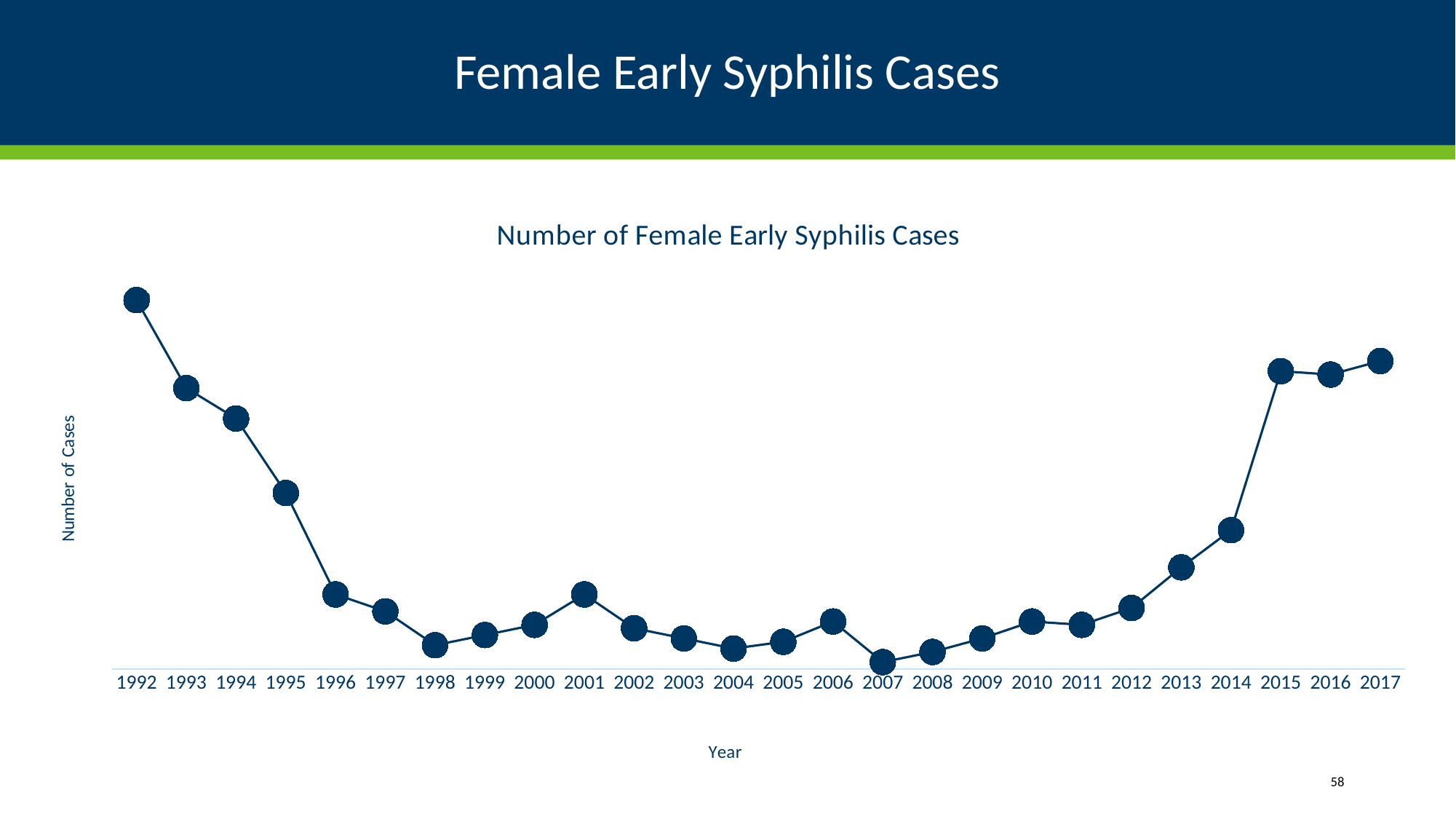
Which year has the lowest number of female early syphilis cases? 2007 Which year has more cases, 2012 or 2013? 2013 Do the number of cases rise or fall from 1992 to 1998? Fall Which year has the highest number of female early syphilis cases? 1992 Do the number of cases rise or fall from 2008 to 2015? Rise Which year has more cases, 1992 or 2017? 1992 How many years are plotted on the chart? 26 Which year has more cases, 1995 or 2014? 1995 What kind of chart is shown on the slide? Line chart What is the title of the chart? Number of Female Early Syphilis Cases What is the label on the vertical axis of the chart? Number of Cases